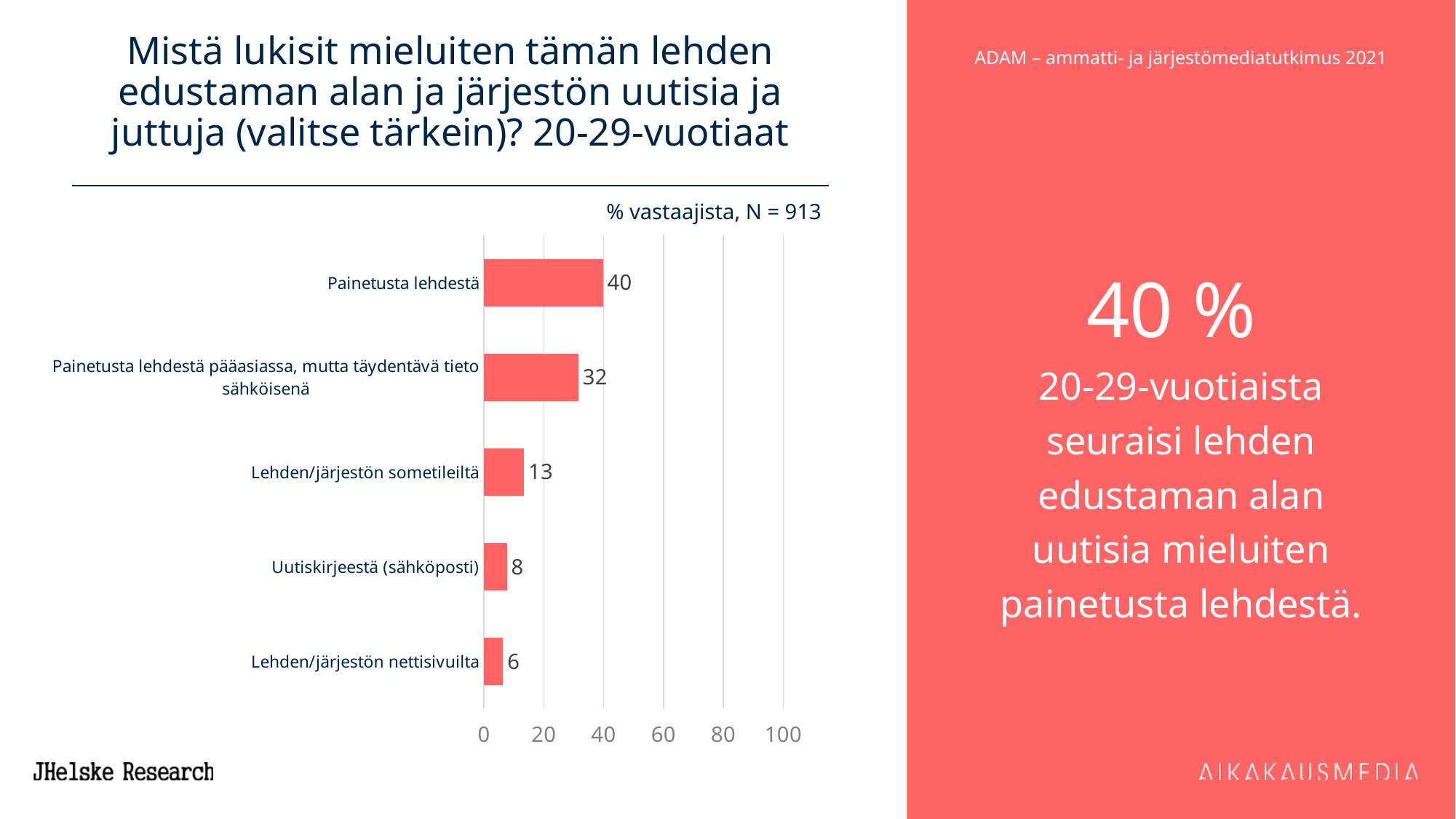
How many categories are shown in the chart? 5 What is the value for "Uutiskirjeestä (sähköposti)"? 8 What is the value for "Lehden/järjestön nettisivuilta"? 6 What is the sample size (N) stated above the chart? 913 Is the value for "Painetusta lehdestä pääasiassa, mutta täydentävä tieto sähköisenä" greater or less than 20? greater What is the value for "Lehden/järjestön sometileiltä"? 13 What kind of chart is shown on the slide? bar chart Which category has the lowest value? Lehden/järjestön nettisivuilta Which is larger: the value for "Lehden/järjestön sometileiltä" or for "Uutiskirjeestä (sähköposti)"? Lehden/järjestön sometileiltä What is the difference between the values for "Painetusta lehdestä" and "Painetusta lehdestä pääasiassa, mutta täydentävä tieto sähköisenä"? 8 Which category has the highest value? Painetusta lehdestä What is the value for "Painetusta lehdestä"? 40